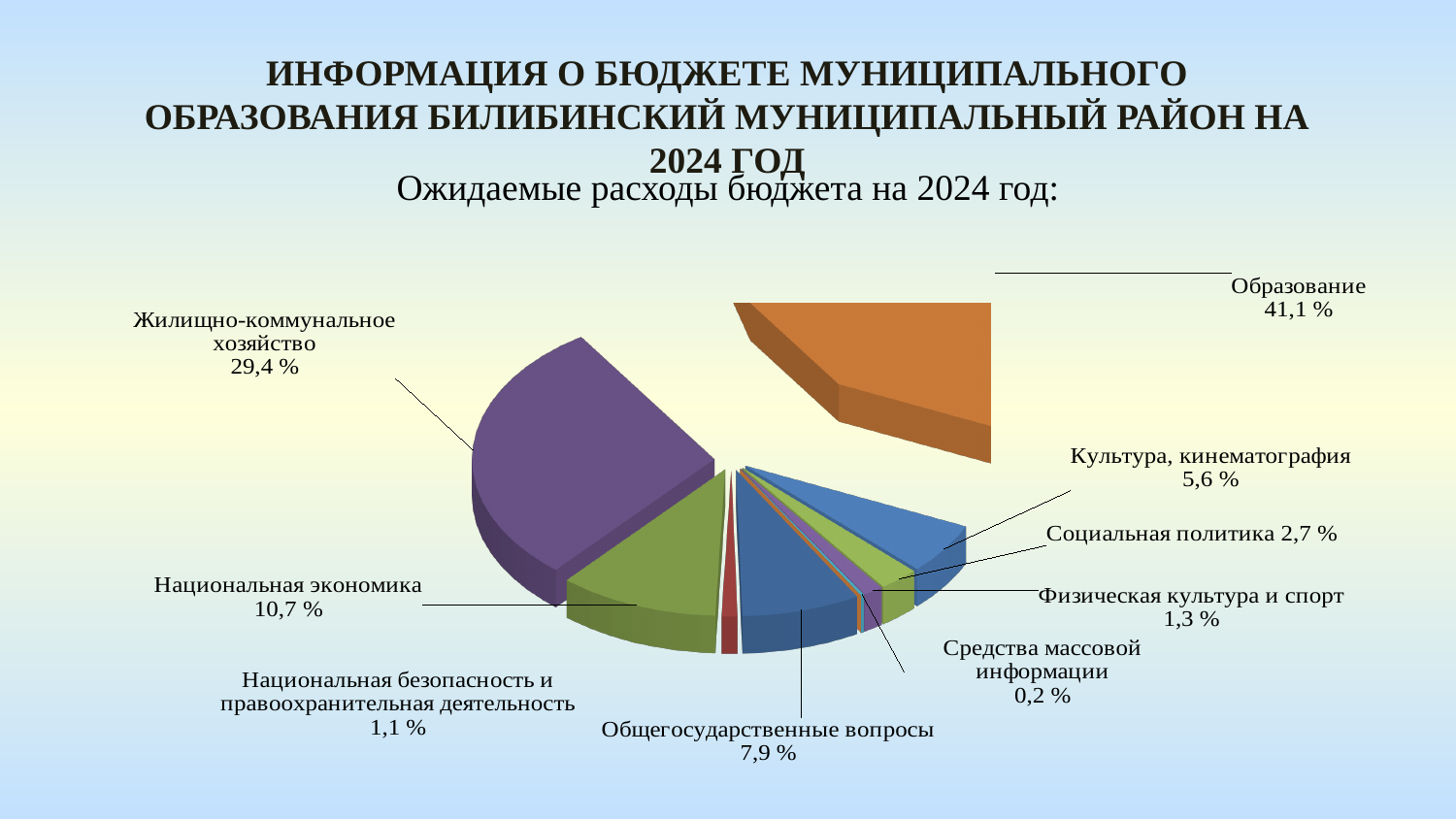
What share is labelled for Средства массовой информации? 0,2 % Which is larger: the share for Культура, кинематография or the share for Социальная политика? Культура, кинематография What share of the pie is labelled Жилищно-коммунальное хозяйство? 29,4 % What percentage is shown for Общегосударственные вопросы? 7,9 % Which category has the smallest share of the pie? Средства массовой информации What share of expected 2024 budget expenditures goes to Образование? 41,1 % Which category has the largest share of expected 2024 budget expenditures? Образование What is the difference in percentage points between Образование and Жилищно-коммунальное хозяйство? 11,7 How many categories are shown in the pie chart? 9 What is the subtitle of the chart on the slide? Ожидаемые расходы бюджета на 2024 год: What percentage is shown for Национальная экономика? 10,7 % What type of chart is used to show the expected 2024 budget expenditures? Pie chart